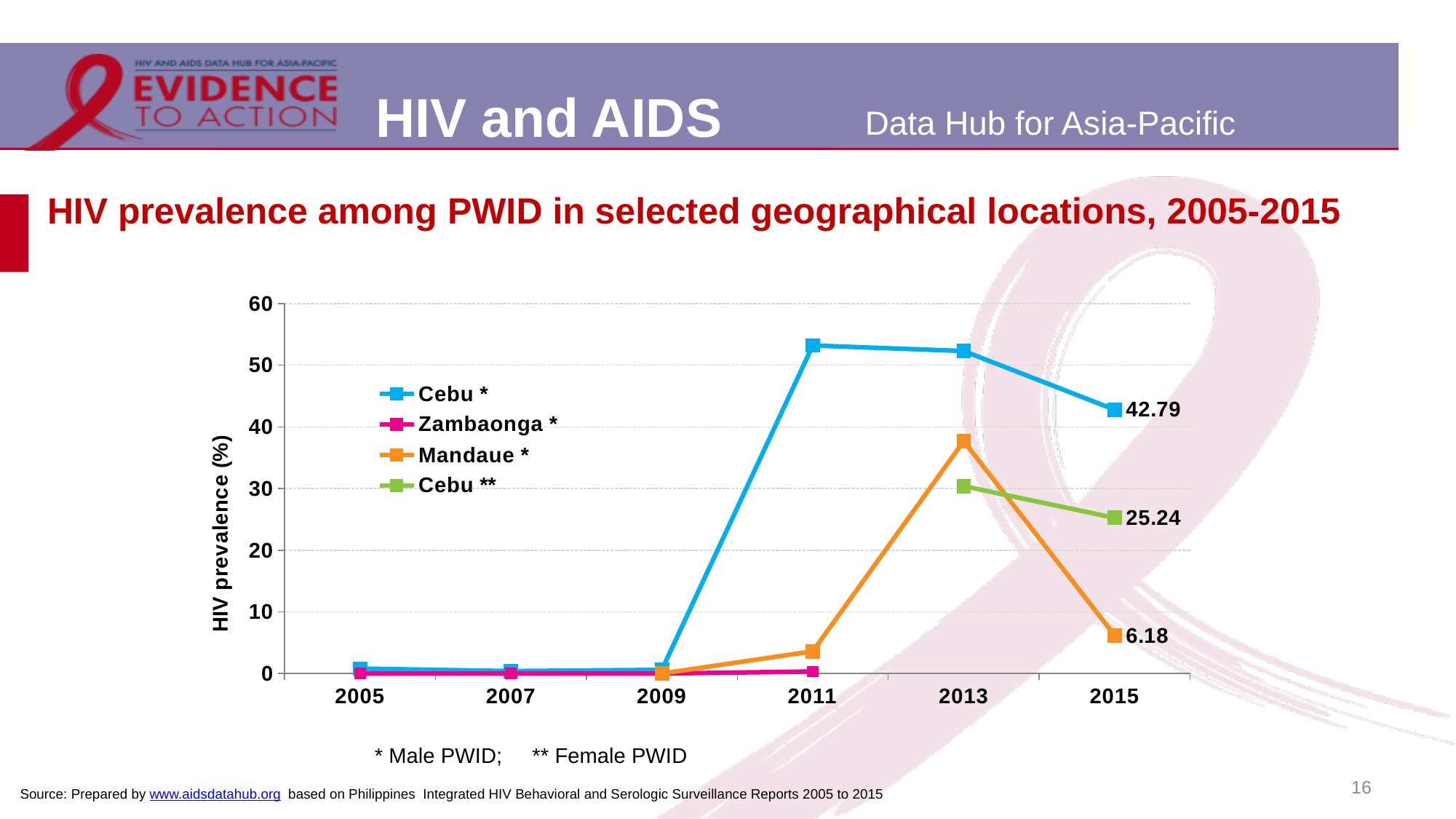
How many series does the legend list? 4 What is the HIV prevalence for Cebu * in 2015? 42.79 Which series has the lowest labelled value in 2015? Mandaue * What is the difference between the 2015 values for Cebu * and Cebu **? 17.55 What is the HIV prevalence for Mandaue * in 2015? 6.18 What is the HIV prevalence for Cebu ** in 2015? 25.24 What type of chart is shown on the slide? line chart How many years are shown on the x axis? 6 Which series has the highest value in 2015? Cebu * Is the value for Mandaue * in 2013 greater or less than 30? greater Is the value for Cebu * in 2011 greater or less than 50? greater In 2015, which is larger: the value for Cebu ** or the value for Mandaue *? Cebu **